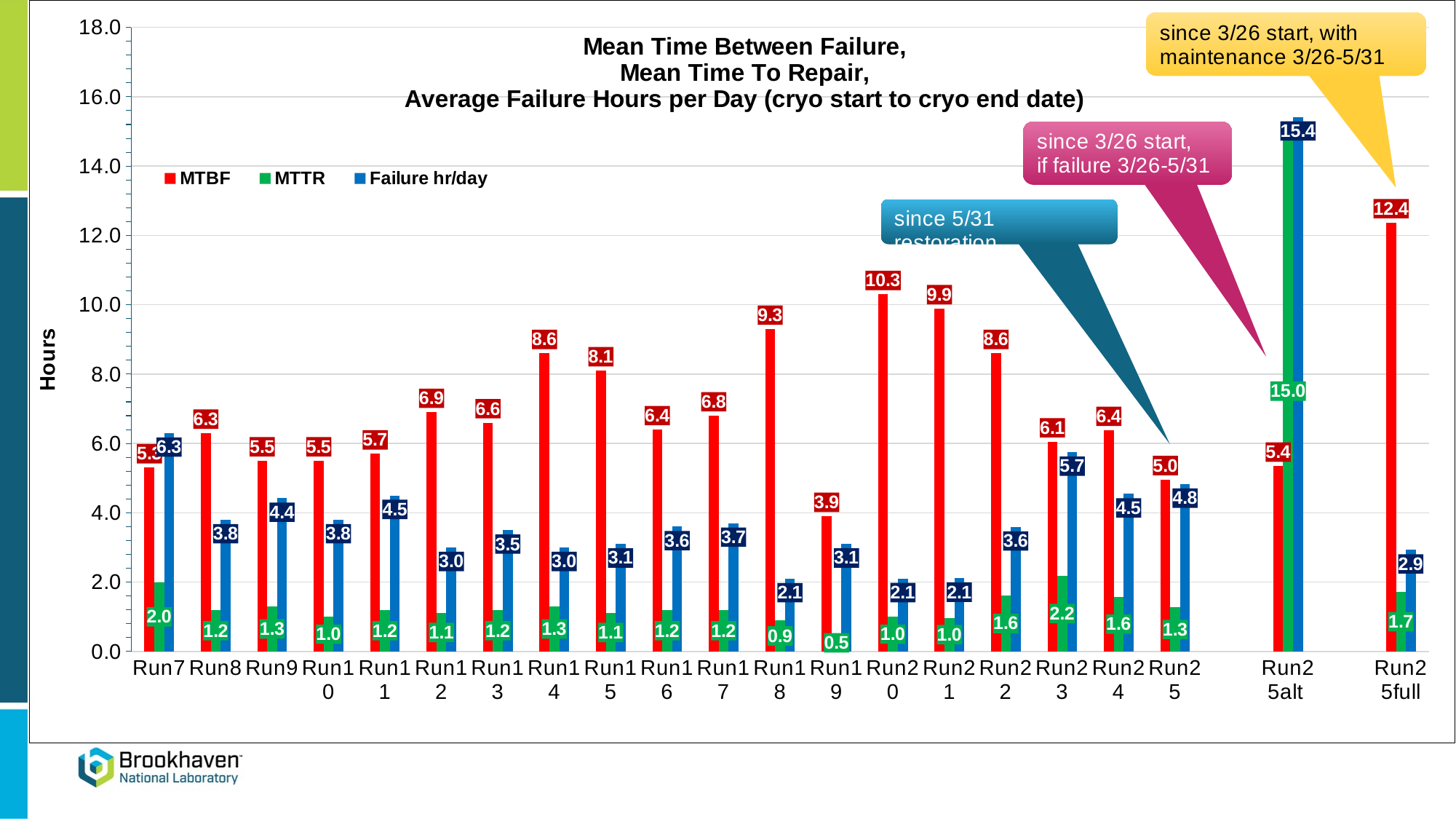
How many series does the legend list? 3 What is the MTBF value for Run20? 10.3 What is the MTTR value for Run25alt? 15.0 Which run has the highest Failure hr/day value? Run25alt Which is larger, the MTBF for Run18 or the MTBF for Run22? Run18 Which run has the highest MTBF value? Run25full Which run has the lowest MTTR value? Run19 What kind of chart is shown on the slide? Bar chart What is the difference between the MTBF values for Run25full and Run25? 7.4 How many run categories are shown on the x axis? 21 Which run has the lowest MTBF value? Run19 What is the Failure hr/day value for Run23? 5.7